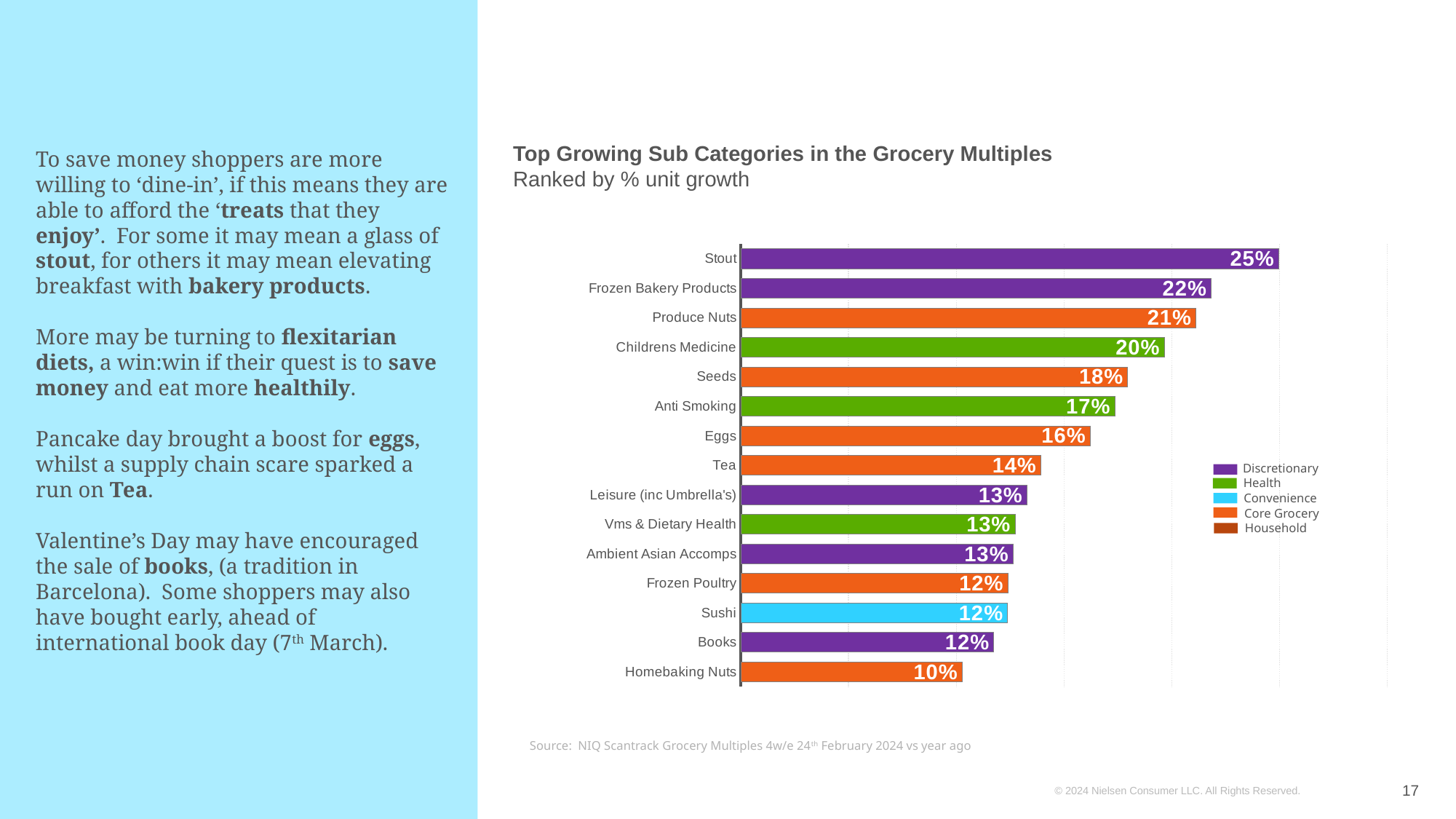
How many categories does the legend list? 5 What is the difference in % unit growth between Seeds and Eggs? 2% How many sub categories are shown in the chart? 15 What is the % unit growth for Childrens Medicine? 20% Which sub category has the highest % unit growth? Stout Which sub category has the lowest % unit growth? Homebaking Nuts What type of chart is shown on the slide? Bar chart Which has higher % unit growth, Produce Nuts or Anti Smoking? Produce Nuts What is the % unit growth for Stout? 25% Which legend category does the Sushi bar belong to? Convenience What is the % unit growth for Sushi? 12% What is the difference in % unit growth between Stout and Frozen Bakery Products? 3%